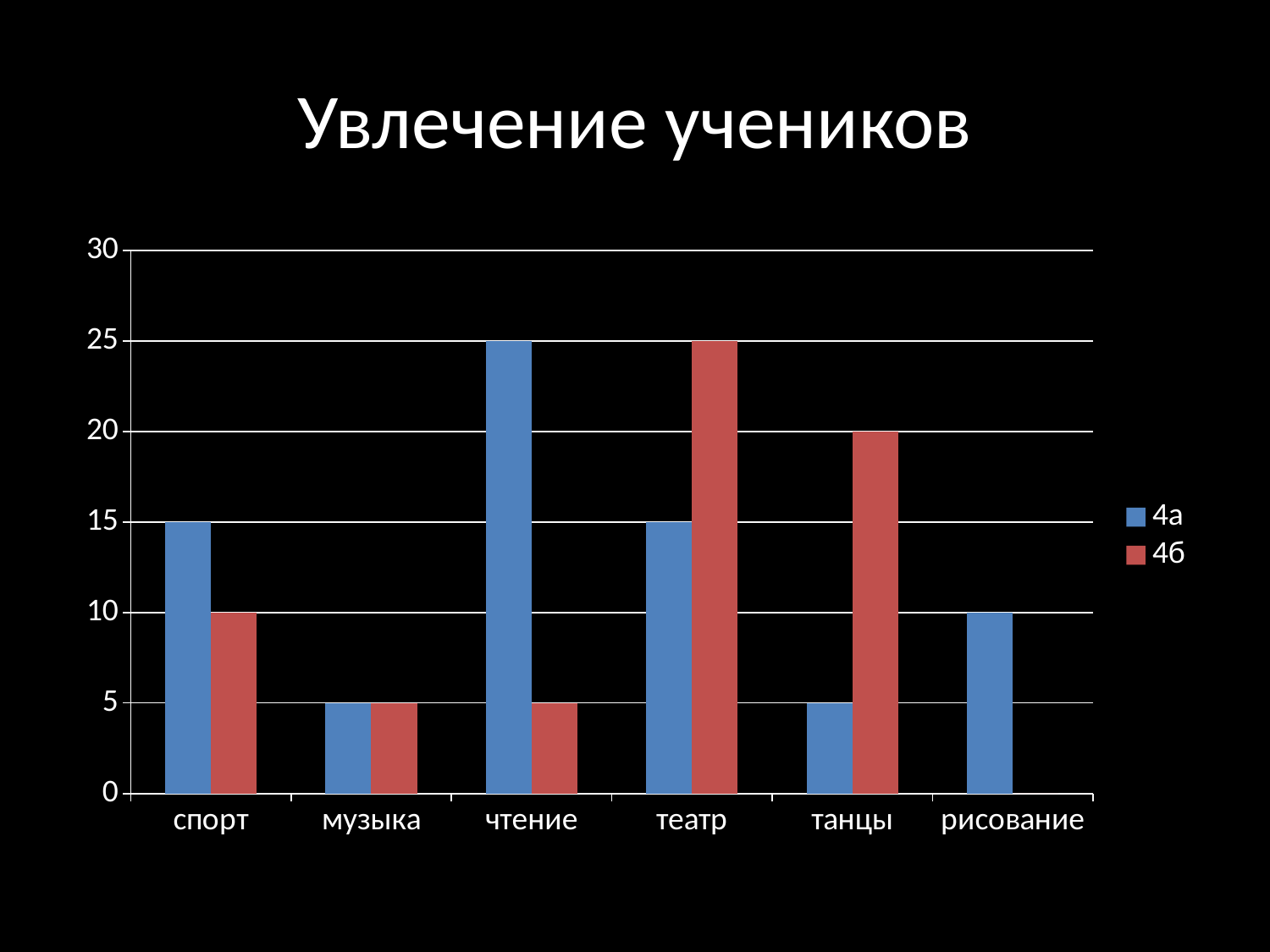
What kind of chart is shown on the slide? bar chart What is the difference between the 4а and 4б values in the category театр? 10 What is the title of the chart? Увлечение учеников How many categories are shown on the x axis? 6 How many series does the legend list? 2 What is the value for 4а in the category чтение? 25 Is the value for 4б in the category чтение greater or less than 10? less What is the value for 4б in the category танцы? 20 What is the value for 4а in the category спорт? 15 Which category has the highest value for the 4а series? чтение Which category has the highest value for the 4б series? театр In the category спорт, which series has the larger value, 4а or 4б? 4а